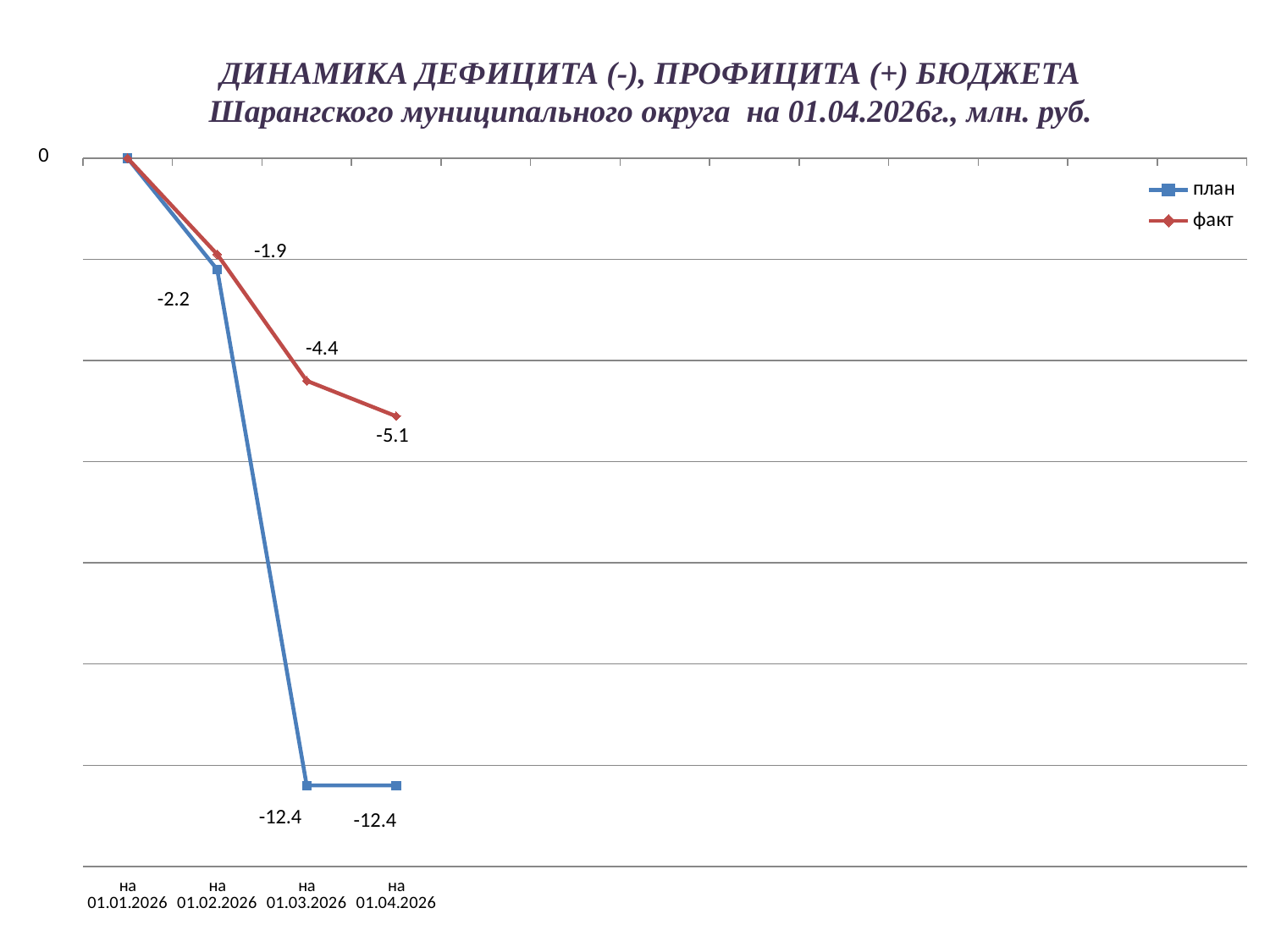
What is the value of the план series on 01.02.2026? -2.2 What is the value of the план series on 01.03.2026? -12.4 Do the values of the факт series rise or fall from 01.01.2026 to 01.04.2026? fall What is the value of the факт series on 01.04.2026? -5.1 What is the difference between the план and факт values on 01.04.2026? 7.3 On which date does the факт series reach its lowest value? на 01.04.2026 What is the value of the факт series on 01.02.2026? -1.9 What kind of chart is shown on the slide? line chart On 01.03.2026, which series has the larger value, план or факт? факт How many series does the legend list? 2 What is the value of the факт series on 01.03.2026? -4.4 How many dates are plotted along the x axis? 4